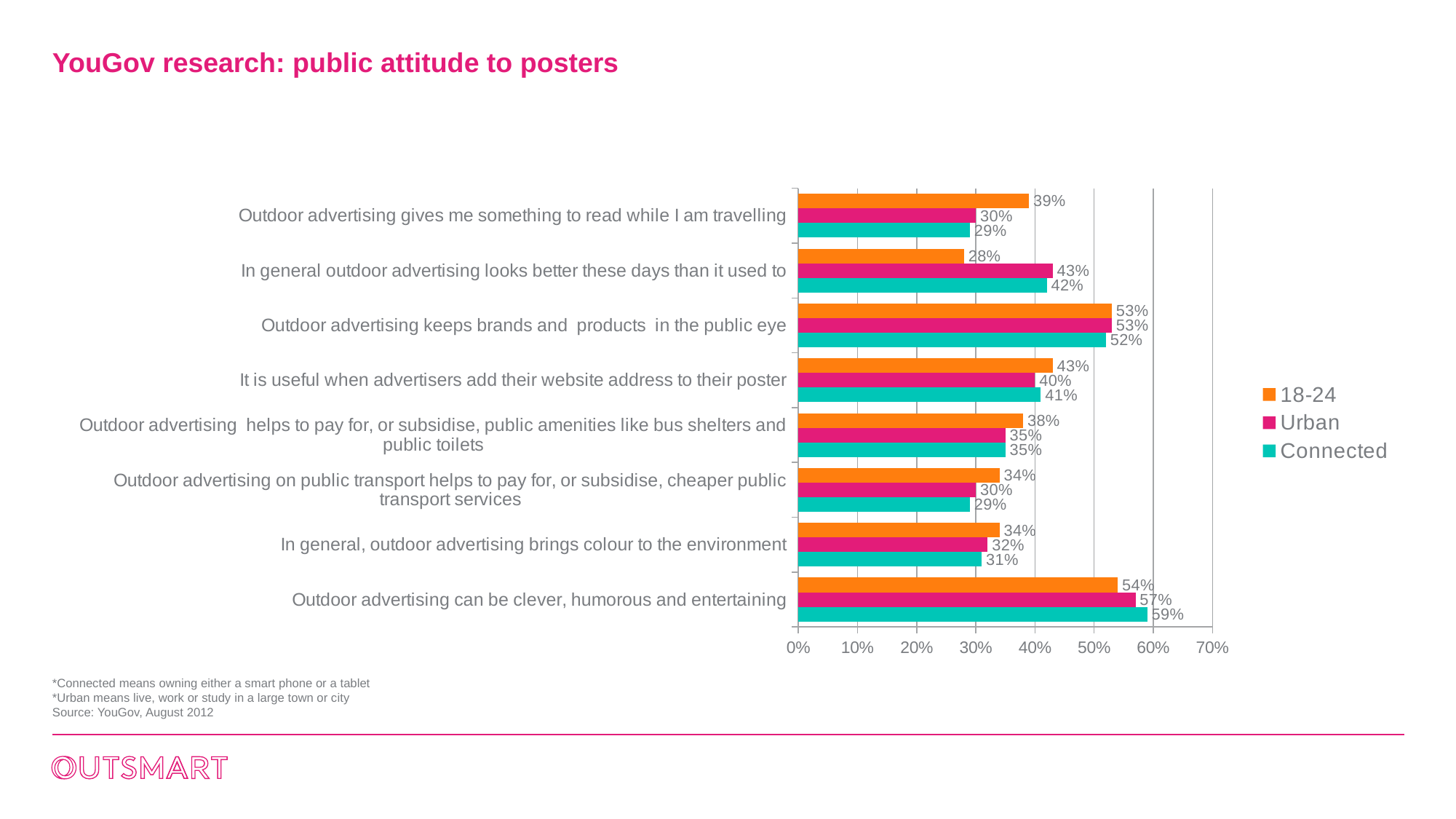
What is the difference between the Urban and Connected values for "Outdoor advertising can be clever, humorous and entertaining"? 2% Which statement has the highest Connected value? Outdoor advertising can be clever, humorous and entertaining What is the Connected value for "Outdoor advertising can be clever, humorous and entertaining"? 59% Is the 18-24 value for "Outdoor advertising keeps brands and products in the public eye" greater or less than 50%? greater What is the value for the 18-24 series for "Outdoor advertising gives me something to read while I am travelling"? 39% What kind of chart is shown on the slide? Bar chart Which statement has the lowest 18-24 value? In general outdoor advertising looks better these days than it used to How many statements (categories) are shown on the chart? 8 How many series does the legend list? 3 For "It is useful when advertisers add their website address to their poster", which is larger: the 18-24 value or the Urban value? 18-24 Which series is shown in orange in the legend? 18-24 What is the Urban value for "In general outdoor advertising looks better these days than it used to"? 43%